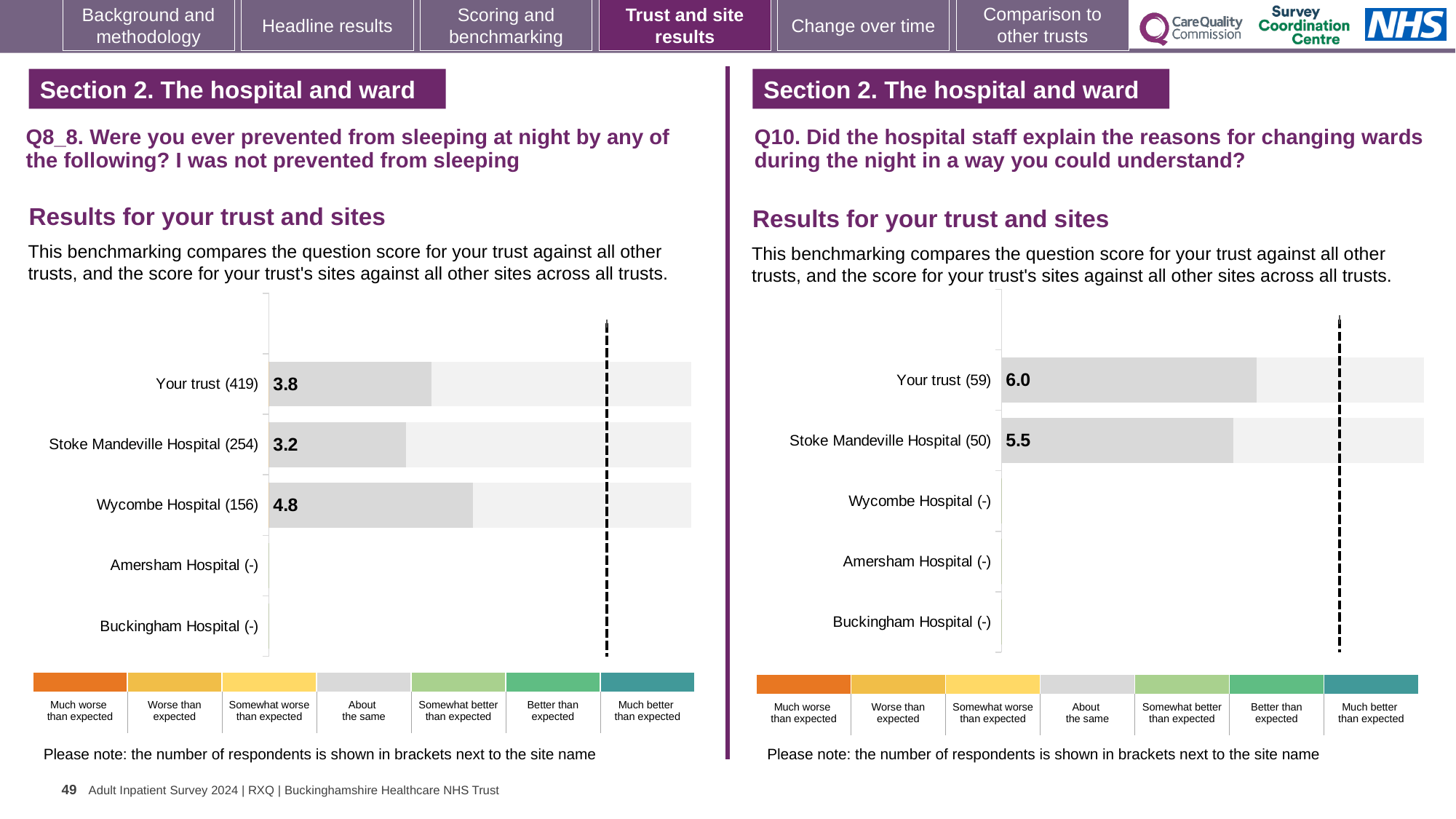
On the right chart (Q10), which is larger, the score for Your trust or for Stoke Mandeville Hospital? Your trust On the right chart (Q10), what is the score for Your trust? 6.0 On the left chart (Q8_8), what is the score for Wycombe Hospital? 4.8 On the left chart (Q8_8), how many respondents are shown in brackets for Your trust? 419 On the left chart (Q8_8), which site or trust has the lowest score? Stoke Mandeville Hospital On the left chart (Q8_8), what is the score for Stoke Mandeville Hospital? 3.2 On the left chart (Q8_8), which site or trust has the highest score? Wycombe Hospital On the left chart (Q8_8), what is the difference between the scores for Wycombe Hospital and Stoke Mandeville Hospital? 1.6 What type of chart is used on the right (Q10)? Bar chart On the left chart (Q8_8), what is the score for Your trust? 3.8 On the right chart (Q10), what is the difference between the scores for Your trust and Stoke Mandeville Hospital? 0.5 On the right chart (Q10), what is the score for Stoke Mandeville Hospital? 5.5